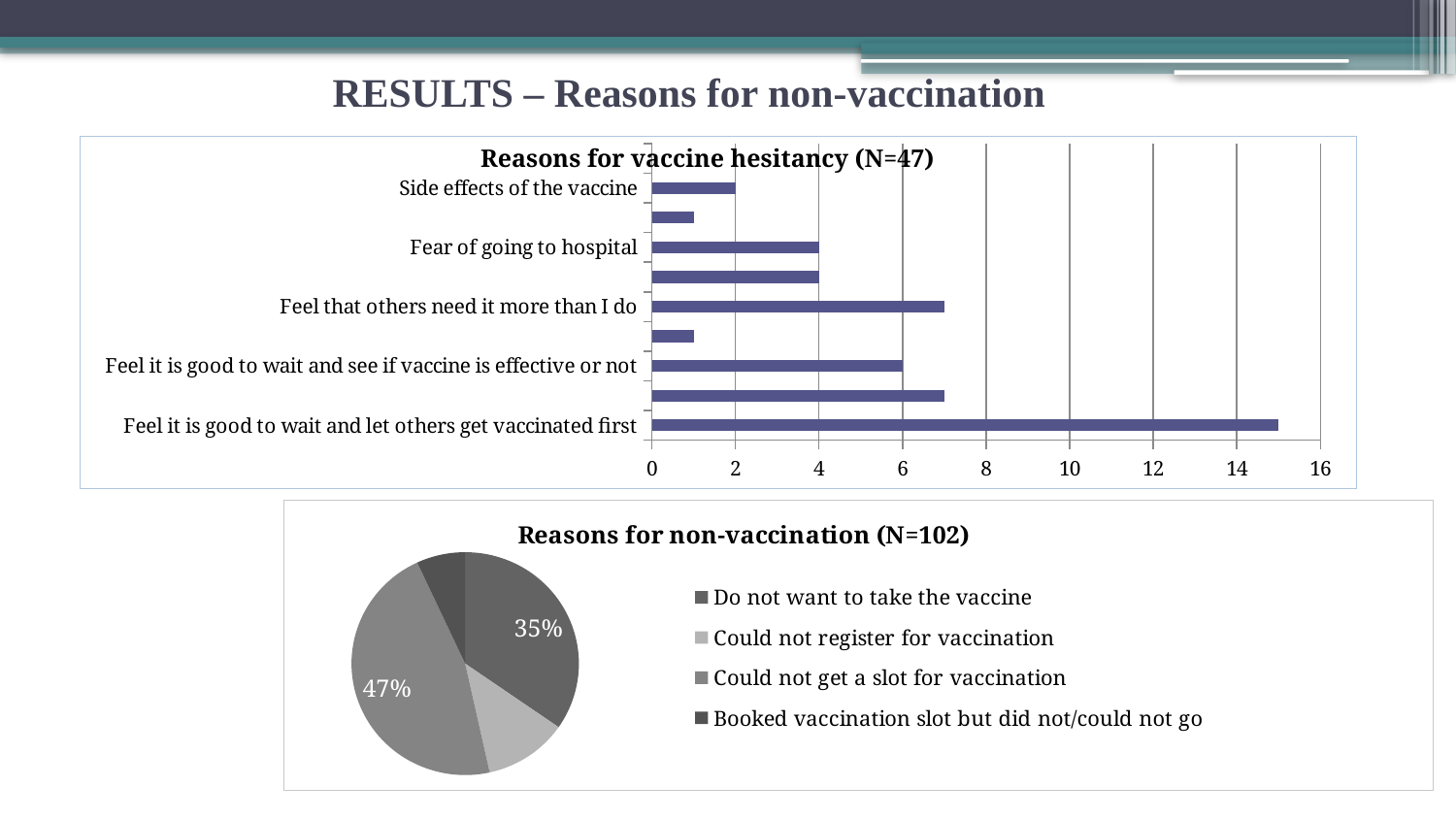
On the 'Reasons for non-vaccination' pie chart, what share is 'Do not want to take the vaccine'? 35% On the 'Reasons for vaccine hesitancy' chart, which is larger: 'Fear of going to hospital' or 'Side effects of the vaccine'? Fear of going to hospital On the 'Reasons for non-vaccination' pie chart, what share is 'Could not get a slot for vaccination'? 47% On the 'Reasons for vaccine hesitancy' chart, what is the value for 'Feel it is good to wait and see if vaccine is effective or not'? 6 On the 'Reasons for vaccine hesitancy' chart, what is the value for 'Fear of going to hospital'? 4 What kind of chart is the 'Reasons for vaccine hesitancy' chart? bar chart On the 'Reasons for vaccine hesitancy' chart, is the value for 'Feel that others need it more than I do' greater or less than 6? greater On the 'Reasons for vaccine hesitancy' chart, which labelled reason has the longest bar? Feel it is good to wait and let others get vaccinated first How many entries does the legend of the 'Reasons for non-vaccination' pie chart list? 4 On the 'Reasons for vaccine hesitancy' chart, what is the value for 'Side effects of the vaccine'? 2 On the 'Reasons for vaccine hesitancy' chart, what is the difference between 'Fear of going to hospital' and 'Side effects of the vaccine'? 2 On the 'Reasons for vaccine hesitancy' chart, is the value for 'Feel it is good to wait and let others get vaccinated first' greater or less than 14? greater